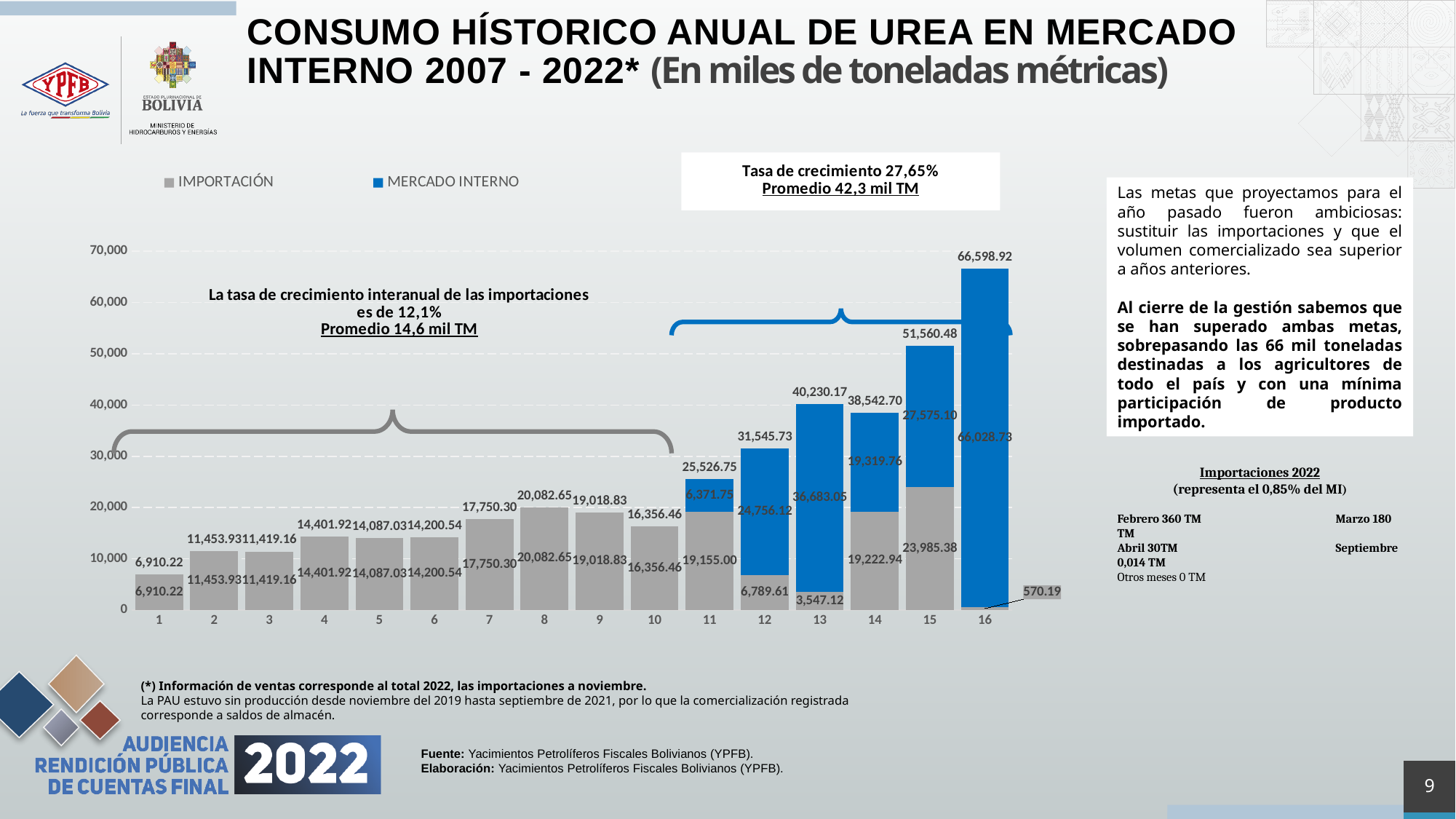
How many categories are shown on the x axis? 16 What is the total of the stacked bar for category 15? 51,560.48 Which category has the highest total bar? 16 Which colour represents MERCADO INTERNO in the legend? Blue What is the difference between the MERCADO INTERNO values for category 16 and category 15? 38,453.63 How many series does the legend list? 2 What is the MERCADO INTERNO value for category 13? 36,683.05 What is the IMPORTACIÓN value for category 7? 17,750.30 What is the IMPORTACIÓN value for category 16? 570.19 What kind of chart is shown on the slide? Stacked bar chart Which category has the lowest total bar? 1 Which has the larger IMPORTACIÓN value, category 15 or category 12? Category 15